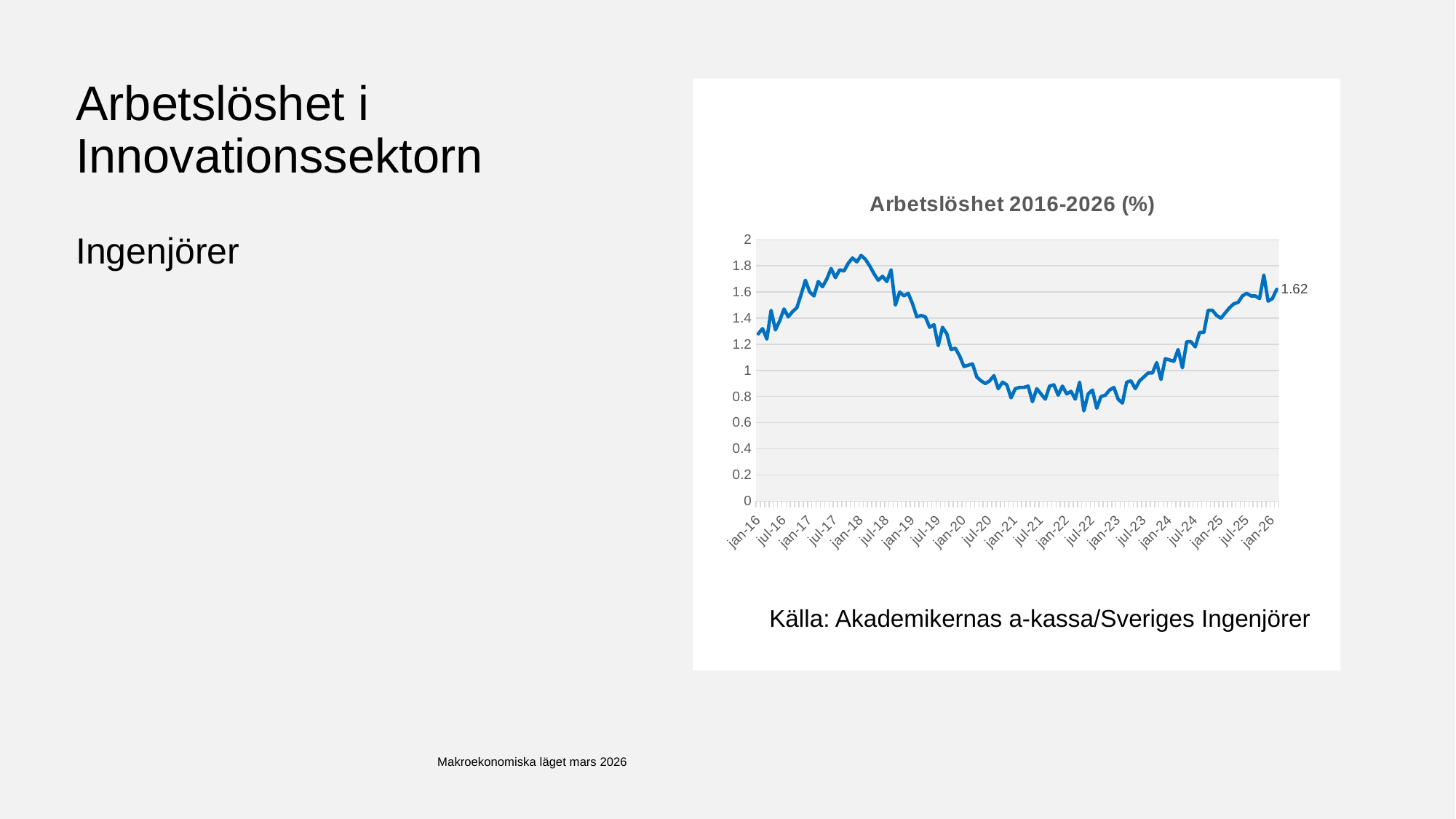
Is the value at jan-21 greater or less than 1.2? less Does the line rise or fall between jul-22 and jan-26? rise Near which x-axis label does the line reach its lowest point? jul-22 What value is printed as the data label at the end of the line (jan-26)? 1.62 Does the line rise or fall between jan-18 and jul-22? fall Near which x-axis label does the line reach its highest point? jan-18 Is the value at jul-22 greater or less than 1? less What kind of chart is shown on the slide? line chart What is the title of the chart? Arbetslöshet 2016-2026 (%) Is the value at jan-16 greater or less than 1.4? less Which is higher, the value at jan-18 or the value at jan-26? jan-18